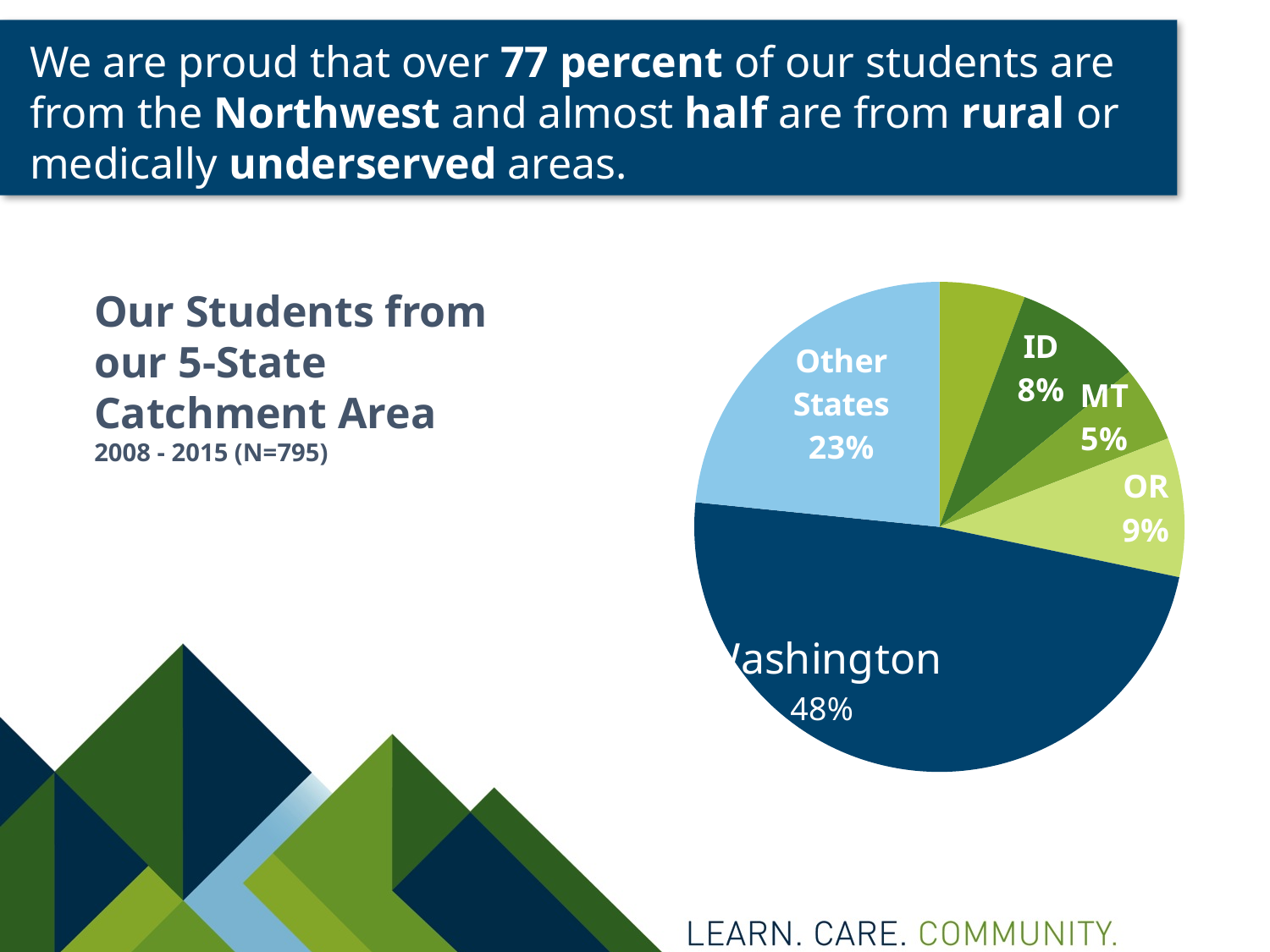
What share of students does the Washington slice represent? 48% What is the value shown for ID? 8% What kind of chart is shown on the slide? Pie chart What is the title of the chart? Our Students from our 5-State Catchment Area Which labeled slice is the smallest? MT Which labeled slice is the largest? Washington What percentage of students are from Other States? 23% Which is larger, the OR slice or the ID slice? OR What time period and sample size does the chart subtitle give? 2008 - 2015 (N=795) What is the value shown for MT? 5% What is the value shown for OR? 9% How many percentage points larger is Washington than Other States? 25